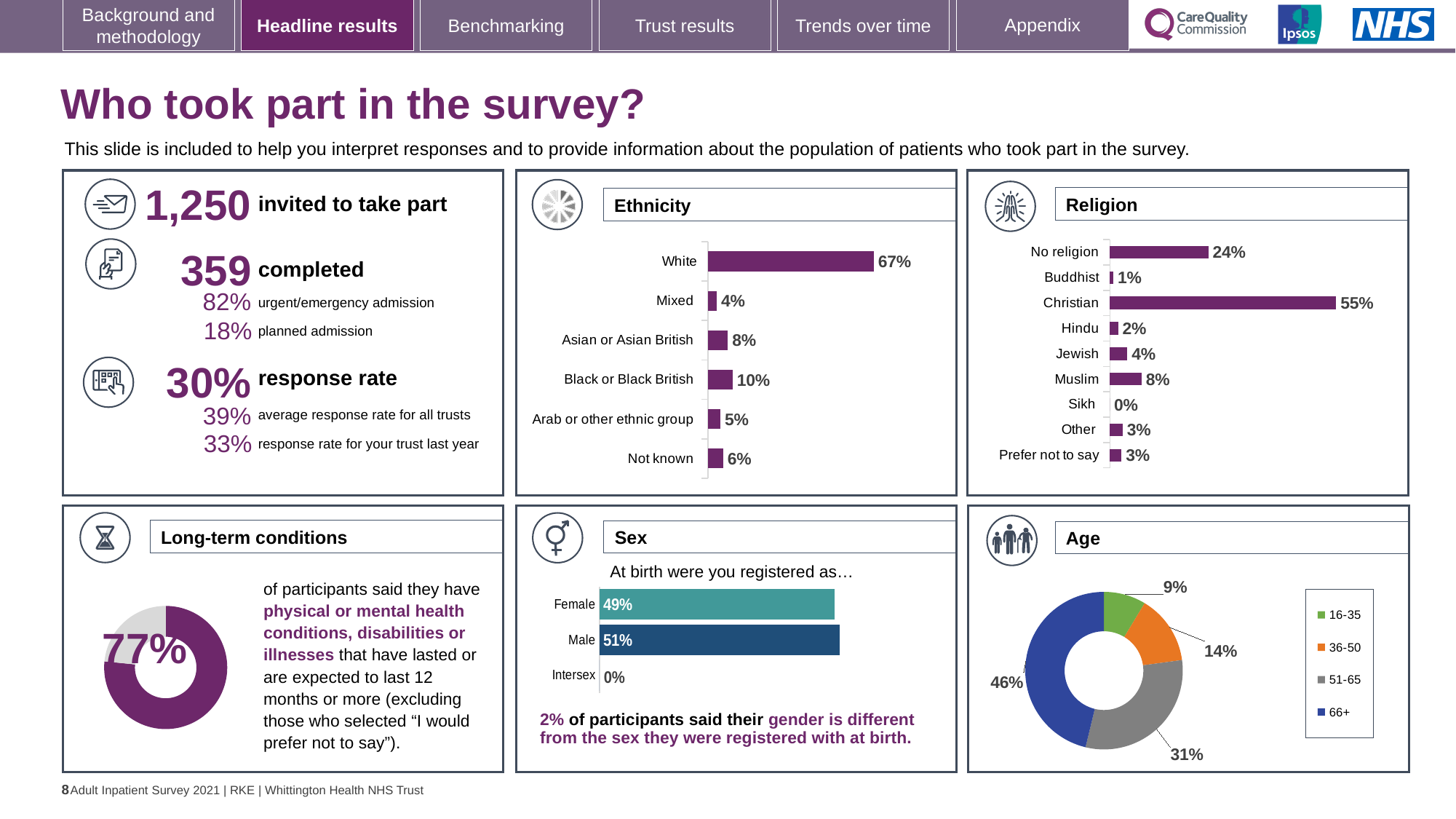
In the Age chart, how many age groups does the legend list? 4 In the Religion chart, which religion category has the highest percentage? Christian In the Ethnicity chart, what is the difference between the Black or Black British and Asian or Asian British percentages? 2% In the Religion chart, what is the difference between No religion and Muslim? 16% In the Age chart, what share of participants were aged 66+? 46% In the Ethnicity chart, how many ethnic group categories are shown? 6 In the Ethnicity chart, which ethnic group has the lowest percentage? Mixed What kind of chart is used in the Age panel? Donut chart In the Sex chart, what percentage of participants were registered as Male at birth? 51% In the Religion chart, what percentage of participants were Christian? 55% In the Ethnicity chart, what percentage of participants were White? 67% In the Religion chart, which is larger: Muslim or Jewish? Muslim